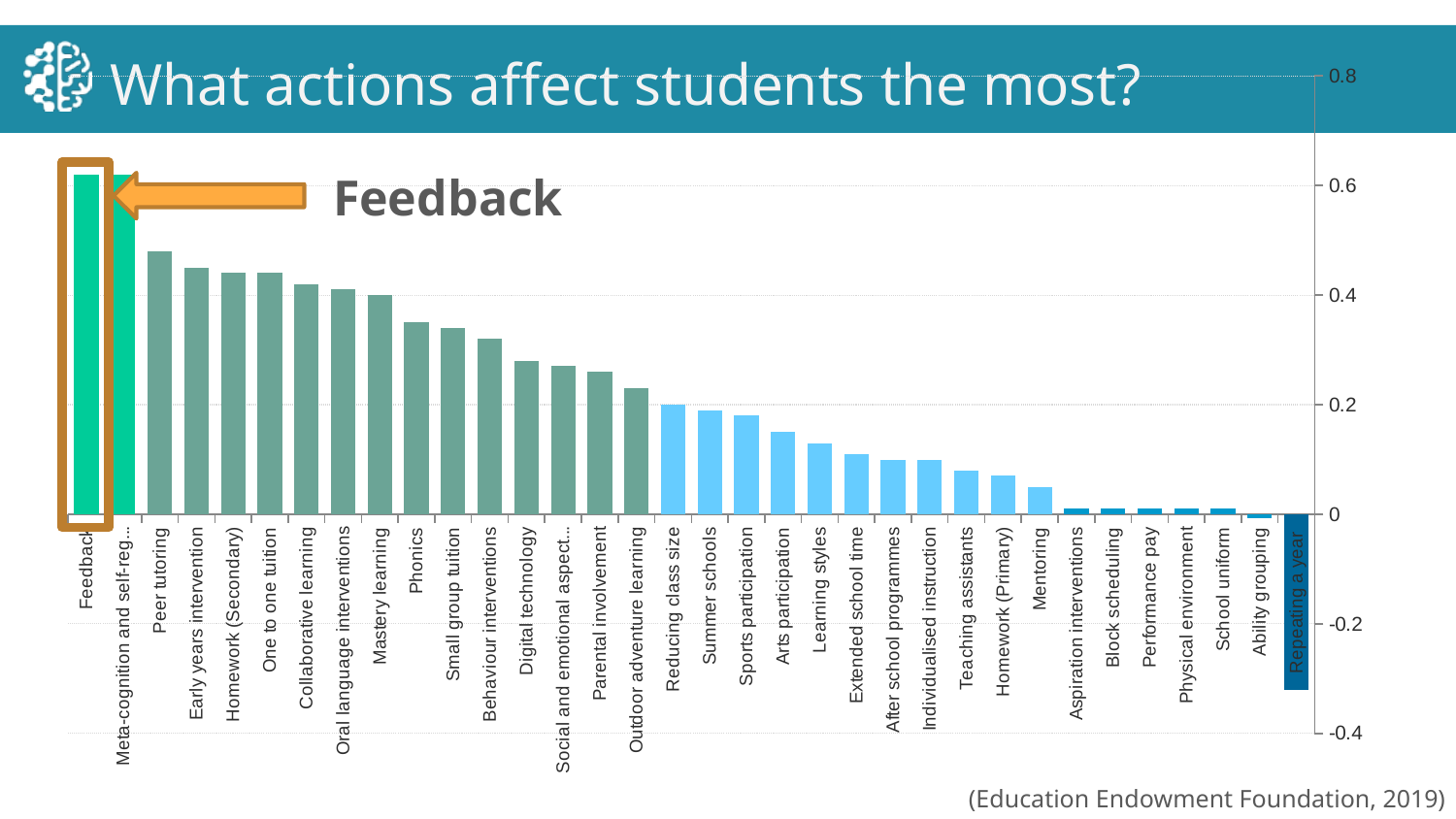
What kind of chart is shown on the slide? bar chart Which has a larger value, Phonics or Summer schools? Phonics Do the bar values rise or fall moving from left to right along the x axis? fall Which has a larger value, Peer tutoring or Mentoring? Peer tutoring Is the value for Peer tutoring greater or less than 0.4? greater Is the value for Repeating a year greater or less than -0.2? less Which category is highlighted with the orange arrow and box on the chart? Feedback Is the value for Phonics greater or less than 0.4? less Which category has the lowest value in the chart? Repeating a year How many categories (bars) are plotted in the chart? 34